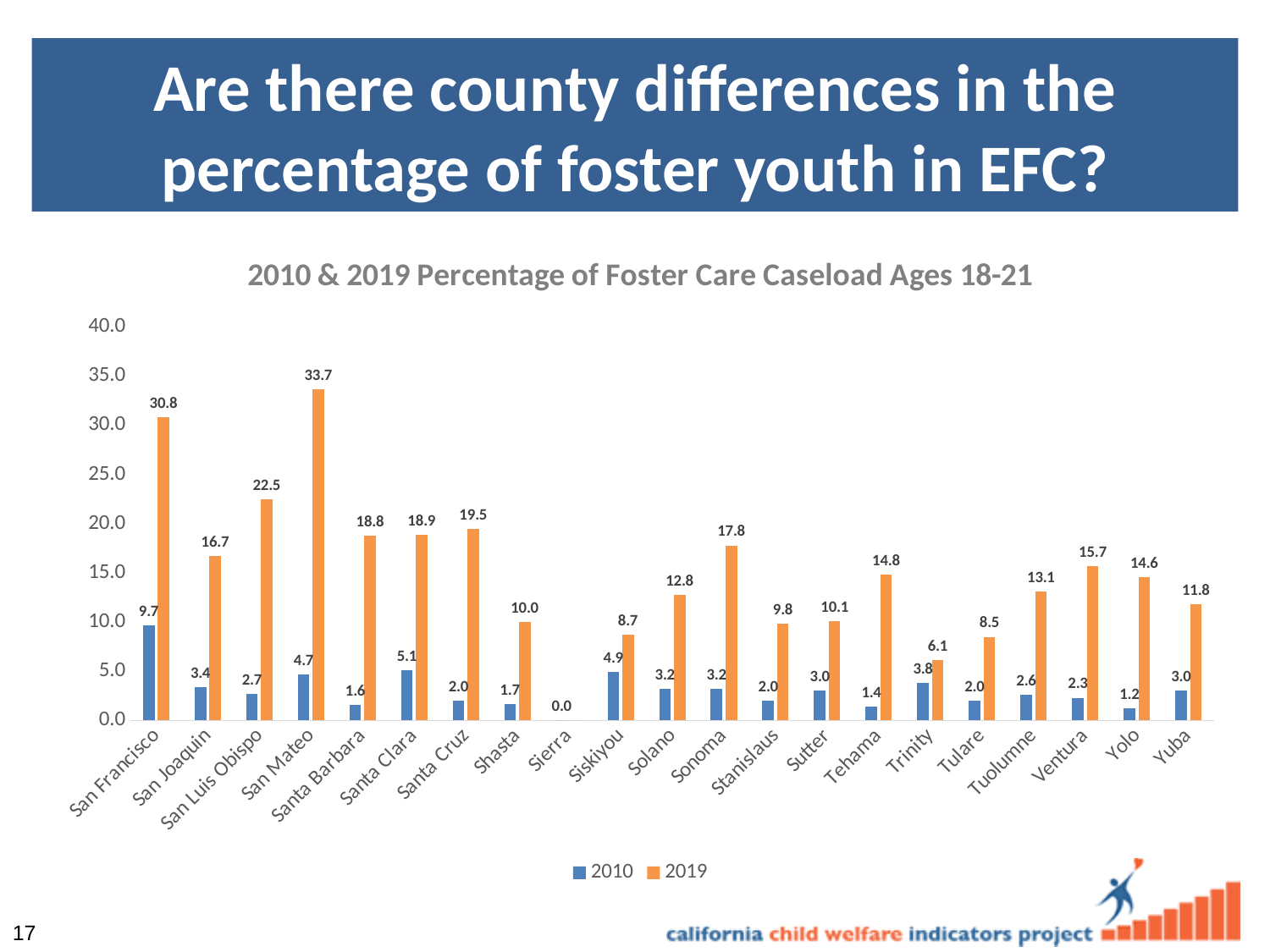
Which county has the lowest 2010 value among those with a non-zero bar? Yolo Which is larger, the 2019 value for Santa Cruz or the 2019 value for Santa Clara? Santa Cruz Which county has the highest 2019 value? San Mateo What is the 2010 value for San Francisco? 9.7 What is the 2019 value for Trinity? 6.1 Is the 2019 value for San Luis Obispo greater or less than 20.0? greater What is the title of the chart? 2010 & 2019 Percentage of Foster Care Caseload Ages 18-21 How many counties are shown on the x axis? 21 What is the difference between the 2019 and 2010 values for San Francisco? 21.1 What is the 2019 value for San Mateo? 33.7 How many series does the legend list? 2 What kind of chart is shown on the slide? bar chart